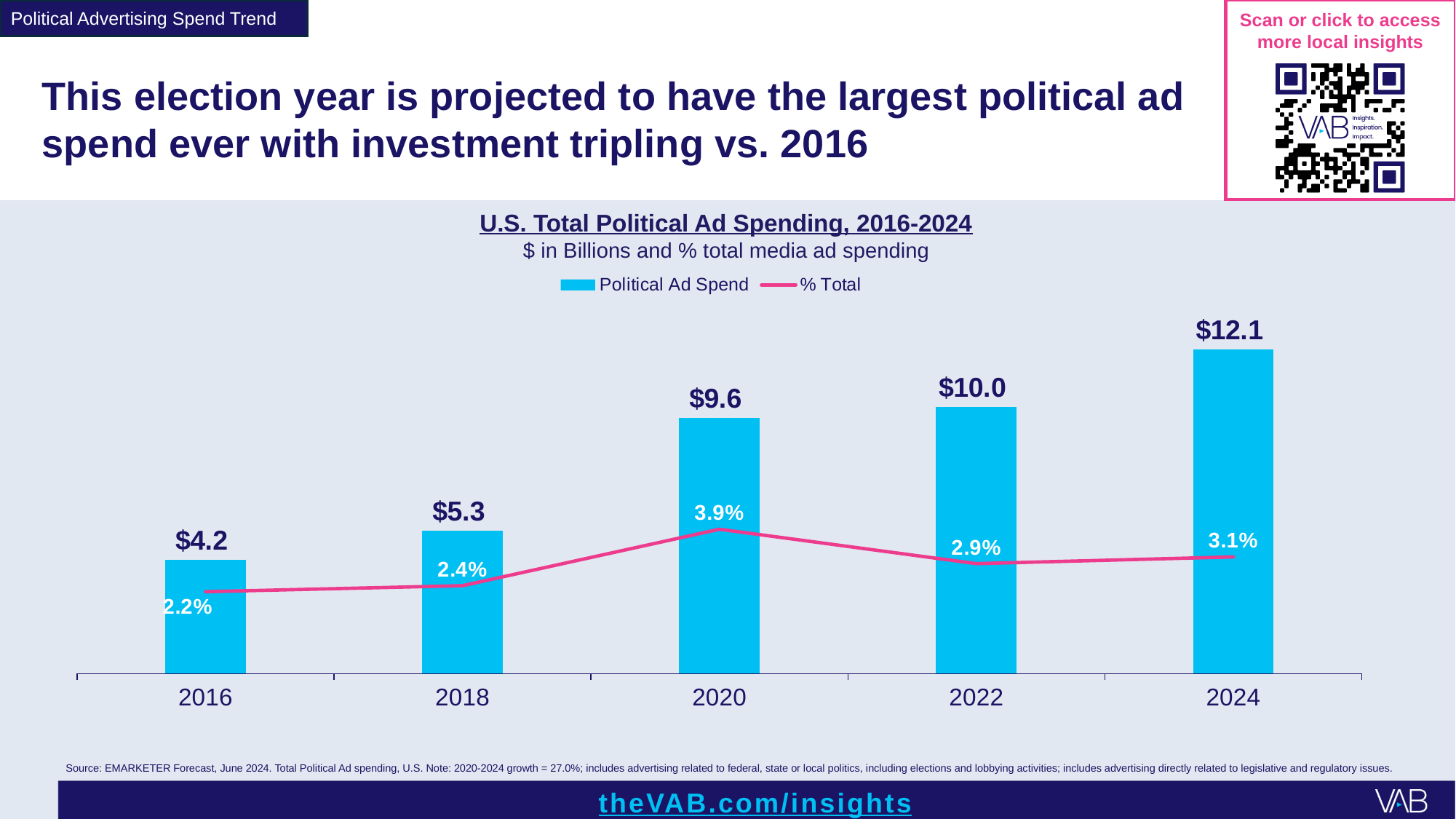
What is the % Total value for 2020? 3.9% How many series does the legend list? 2 What is the Political Ad Spend value for 2024? $12.1 How many years are shown on the x axis? 5 Does Political Ad Spend rise or fall from 2016 to 2024? Rise What is the title of the chart? U.S. Total Political Ad Spending, 2016-2024 Which year has the highest Political Ad Spend? 2024 Which year has the higher % Total, 2022 or 2024? 2024 What kind of chart is used to show Political Ad Spend? Bar chart What is the Political Ad Spend value for 2016? $4.2 Which year has the lowest % Total? 2016 What is the difference in Political Ad Spend between 2024 and 2016? $7.9